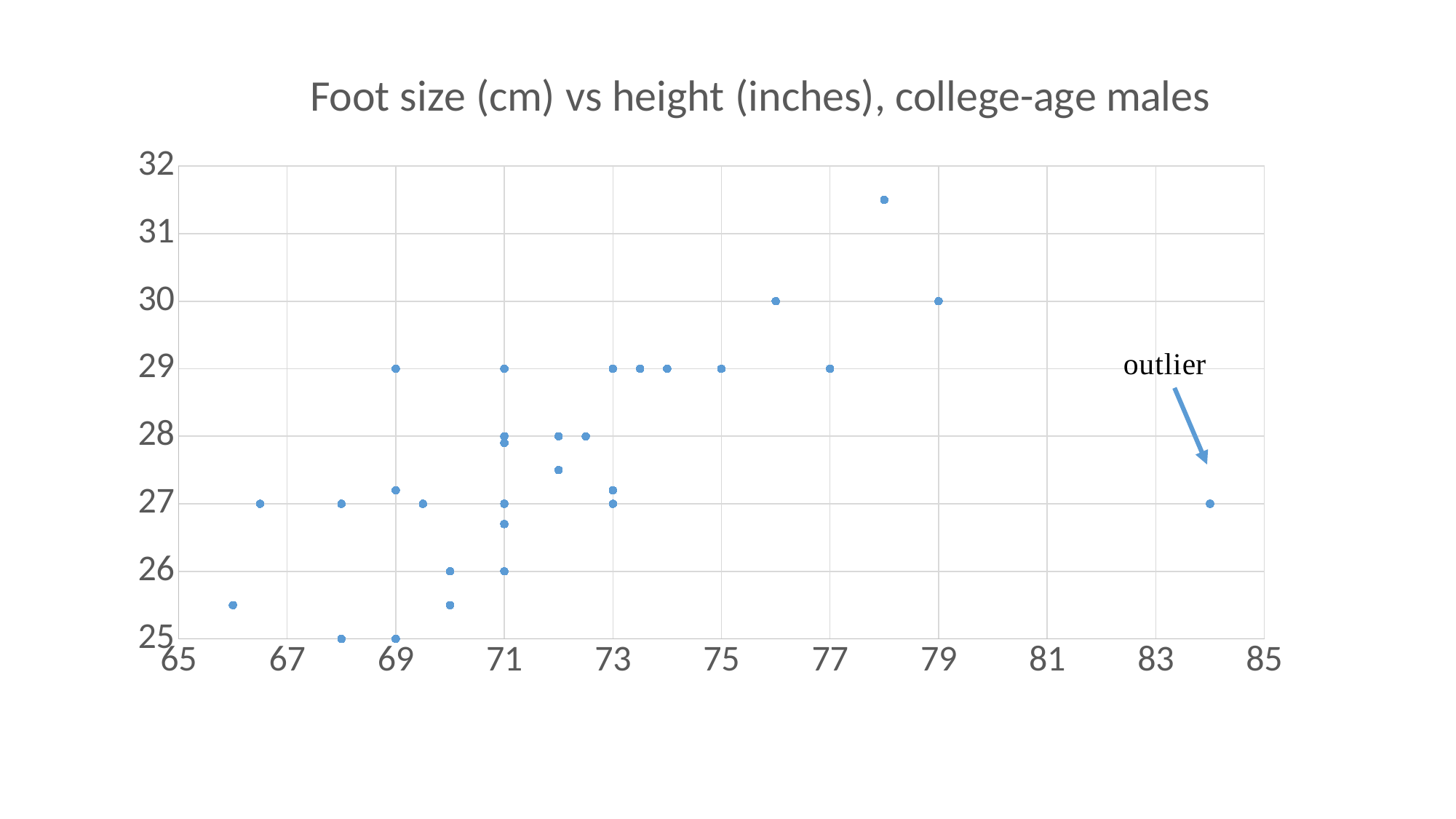
Which has the larger foot size: the point at height 79 or the point at height 84? the point at height 79 What foot size (cm) is plotted at a height of 77 inches? 29 What is the title of the chart? Foot size (cm) vs height (inches), college-age males What is the smallest foot size (cm) plotted on the chart? 25 What kind of chart is shown on the slide? scatter plot What foot size (cm) is plotted at a height of 79 inches? 30 What foot size (cm) does the point labelled as the outlier have? 27 Is the largest foot size plotted greater or less than 31? greater Ignoring the outlier, does foot size generally rise or fall as height increases? rise What word does the annotation with the arrow on the chart say? outlier Is the height of the point with the largest foot size greater or less than 77? greater